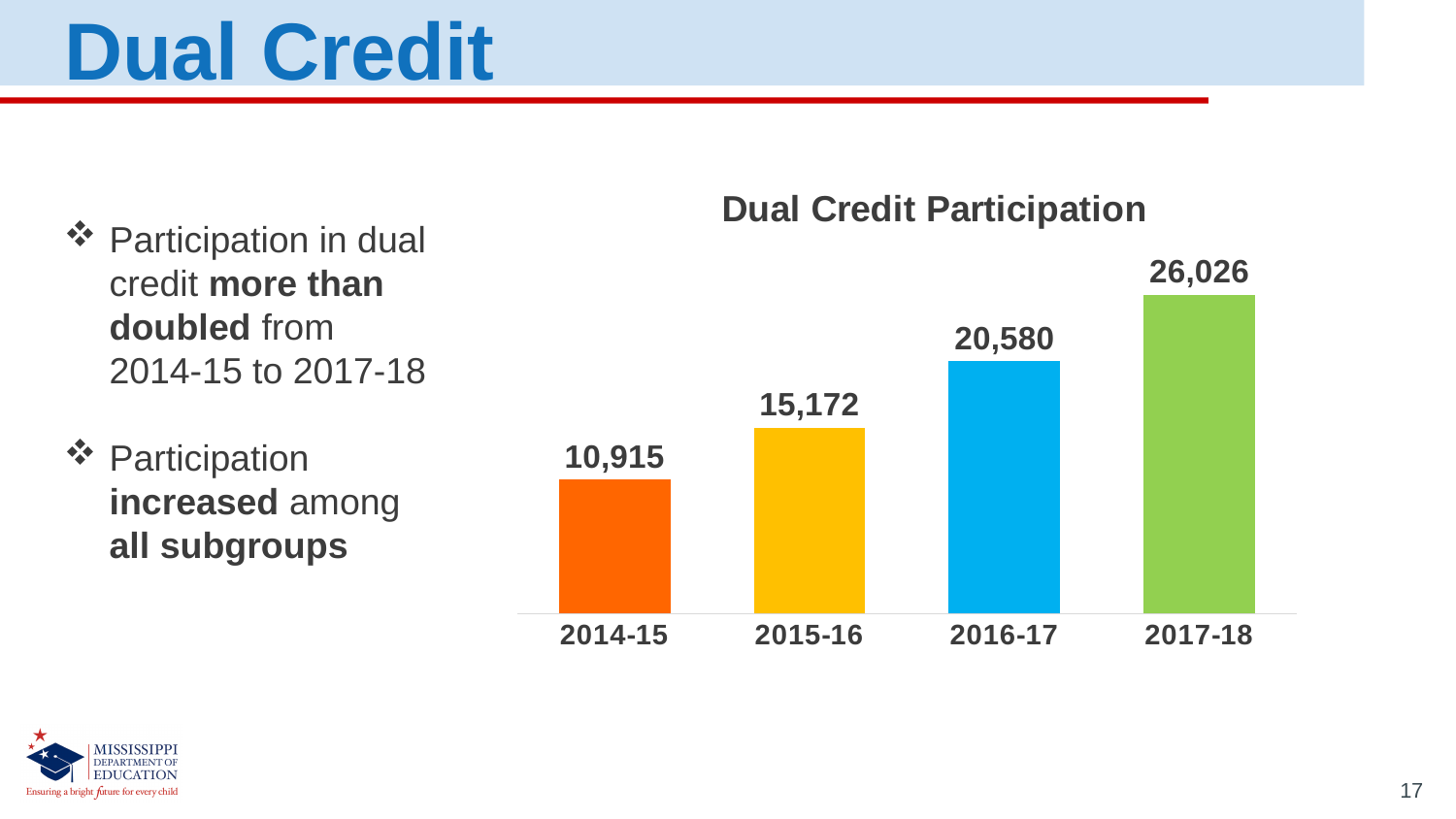
What is the dual credit participation value for 2016-17? 20,580 What is the difference in dual credit participation between 2017-18 and 2014-15? 15,111 What is the dual credit participation value for 2015-16? 15,172 What is the dual credit participation value for 2017-18? 26,026 What kind of chart is the Dual Credit Participation chart? Bar chart What is the difference in dual credit participation between 2016-17 and 2015-16? 5,408 What is the dual credit participation value for 2014-15? 10,915 Which year has higher dual credit participation, 2015-16 or 2016-17? 2016-17 Which year has the lowest dual credit participation? 2014-15 How many years are shown in the Dual Credit Participation chart? 4 Does dual credit participation rise or fall from 2014-15 to 2017-18? Rise Which year has the highest dual credit participation? 2017-18